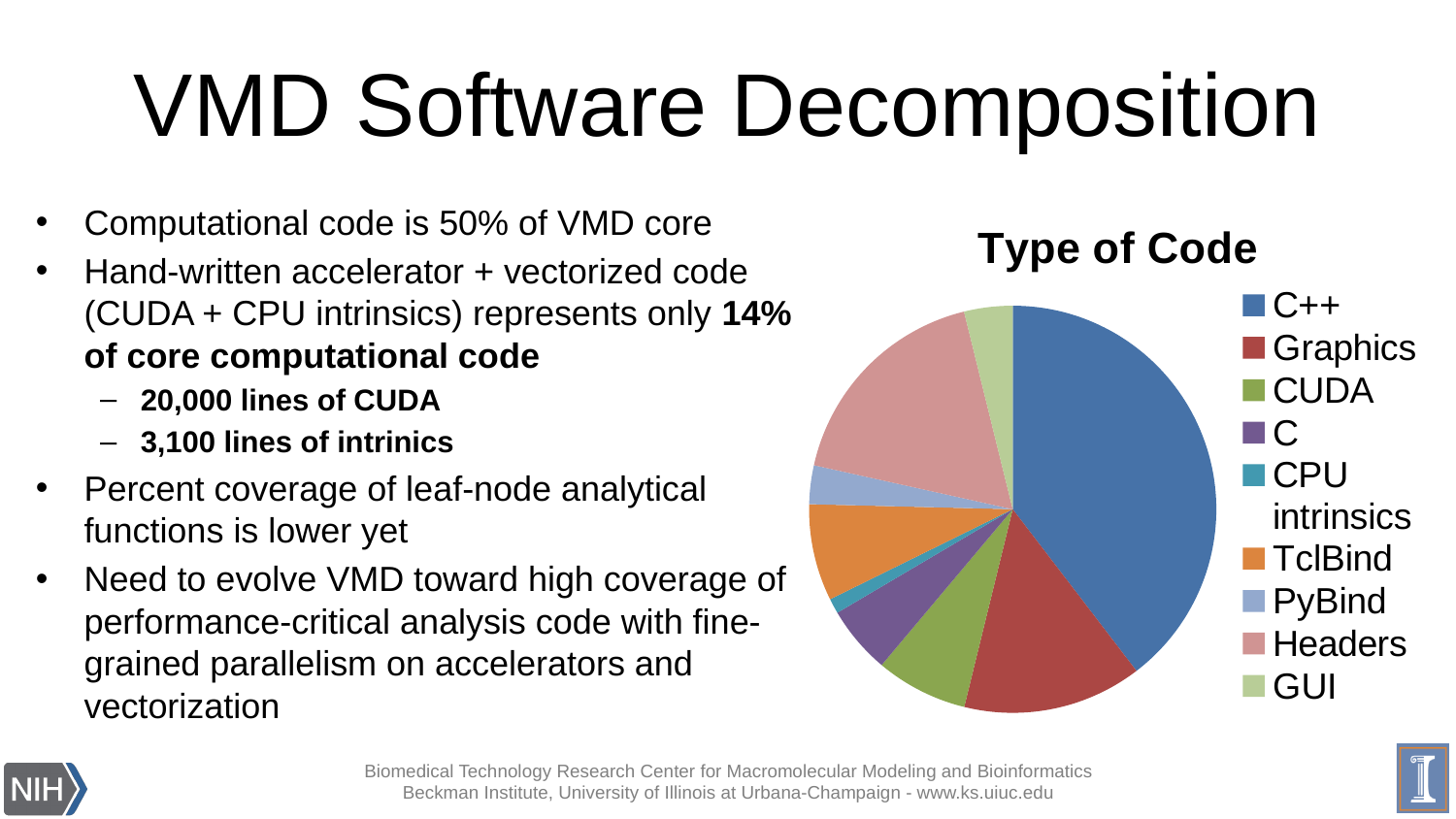
Which type of code has the largest slice of the pie? C++ What kind of chart is shown on the slide? Pie chart What is the title of the chart? Type of Code Which type of code has the smallest slice of the pie? CPU intrinsics Which slice is larger, TclBind or CPU intrinsics? TclBind Which slice is larger, Headers or GUI? Headers How many categories does the legend of the pie chart list? 9 Which slice is larger, C++ or Graphics? C++ What colour is the C++ slice in the pie chart? Blue Which legend entry is listed last in the pie chart's legend? GUI